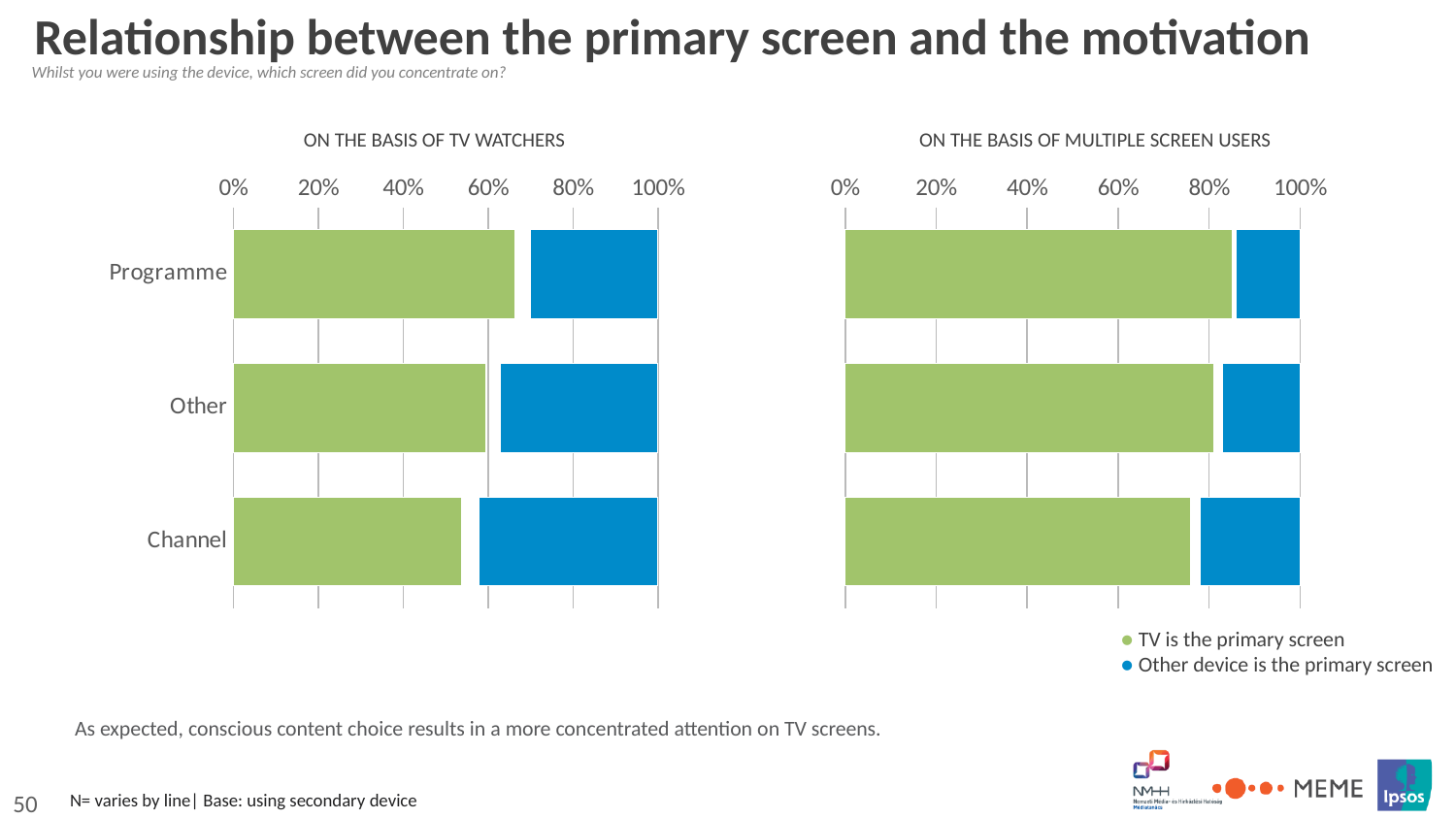
In the 'ON THE BASIS OF TV WATCHERS' chart, which is larger for 'Other device is the primary screen': Programme or Channel? Channel In the 'ON THE BASIS OF TV WATCHERS' chart, which category has the highest share for 'TV is the primary screen'? Programme How many series does the legend list for the charts? 2 In the 'ON THE BASIS OF MULTIPLE SCREEN USERS' chart, is the value for 'TV is the primary screen' for Channel greater or less than 80%? less In the 'ON THE BASIS OF MULTIPLE SCREEN USERS' chart, does the share for 'TV is the primary screen' rise or fall going from Programme down to Channel? fall Which colour represents 'TV is the primary screen' in the legend? Green What kind of chart is used on the slide for 'ON THE BASIS OF TV WATCHERS'? Stacked bar chart In the 'ON THE BASIS OF TV WATCHERS' chart, is the value for 'TV is the primary screen' for Programme greater or less than 60%? greater In the 'ON THE BASIS OF TV WATCHERS' chart, is the value for 'TV is the primary screen' for Channel greater or less than 60%? less How many categories are shown in the 'ON THE BASIS OF TV WATCHERS' chart? 3 In the 'ON THE BASIS OF MULTIPLE SCREEN USERS' chart, which category has the lowest share for 'TV is the primary screen'? Channel